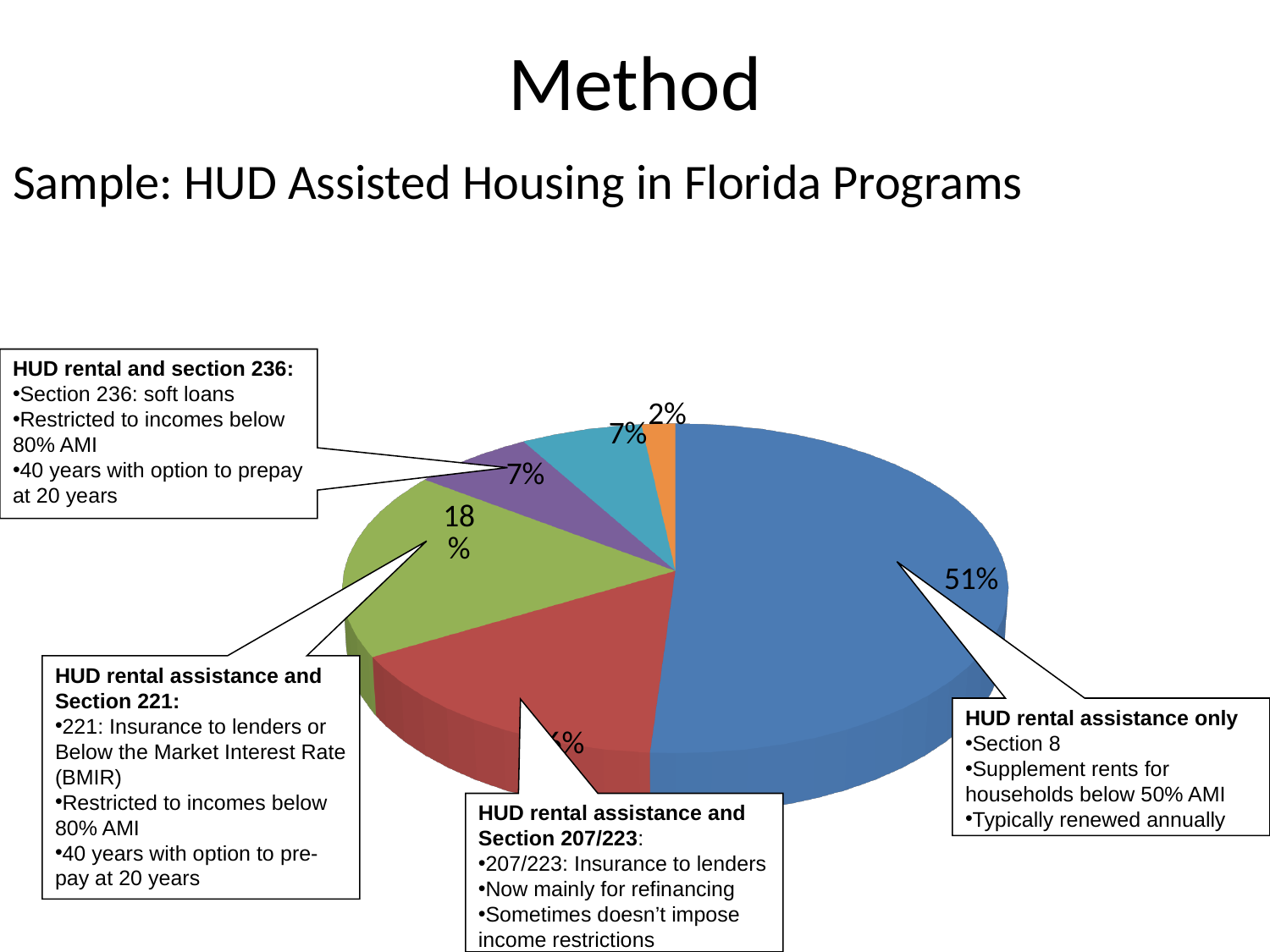
What share of the pie is labelled for HUD rental and section 236? 7% What kind of chart is shown on the slide? pie chart What colour is the slice for HUD rental assistance only? blue How many percentage points larger is the HUD rental assistance only slice than the Section 221 slice? 33 percentage points What share of the pie is labelled for HUD rental assistance only? 51% Is the share for HUD rental assistance only greater or less than 50%? greater What percentage is printed on the smallest slice of the pie? 2% How many slices does the pie chart have? 6 Which has a larger share: HUD rental assistance and Section 221, or HUD rental and section 236? HUD rental assistance and Section 221 What share of the pie is labelled for HUD rental assistance and Section 221? 18% Which program category has the largest slice of the pie? HUD rental assistance only How many percentage points larger is the Section 221 slice than the section 236 slice? 11 percentage points